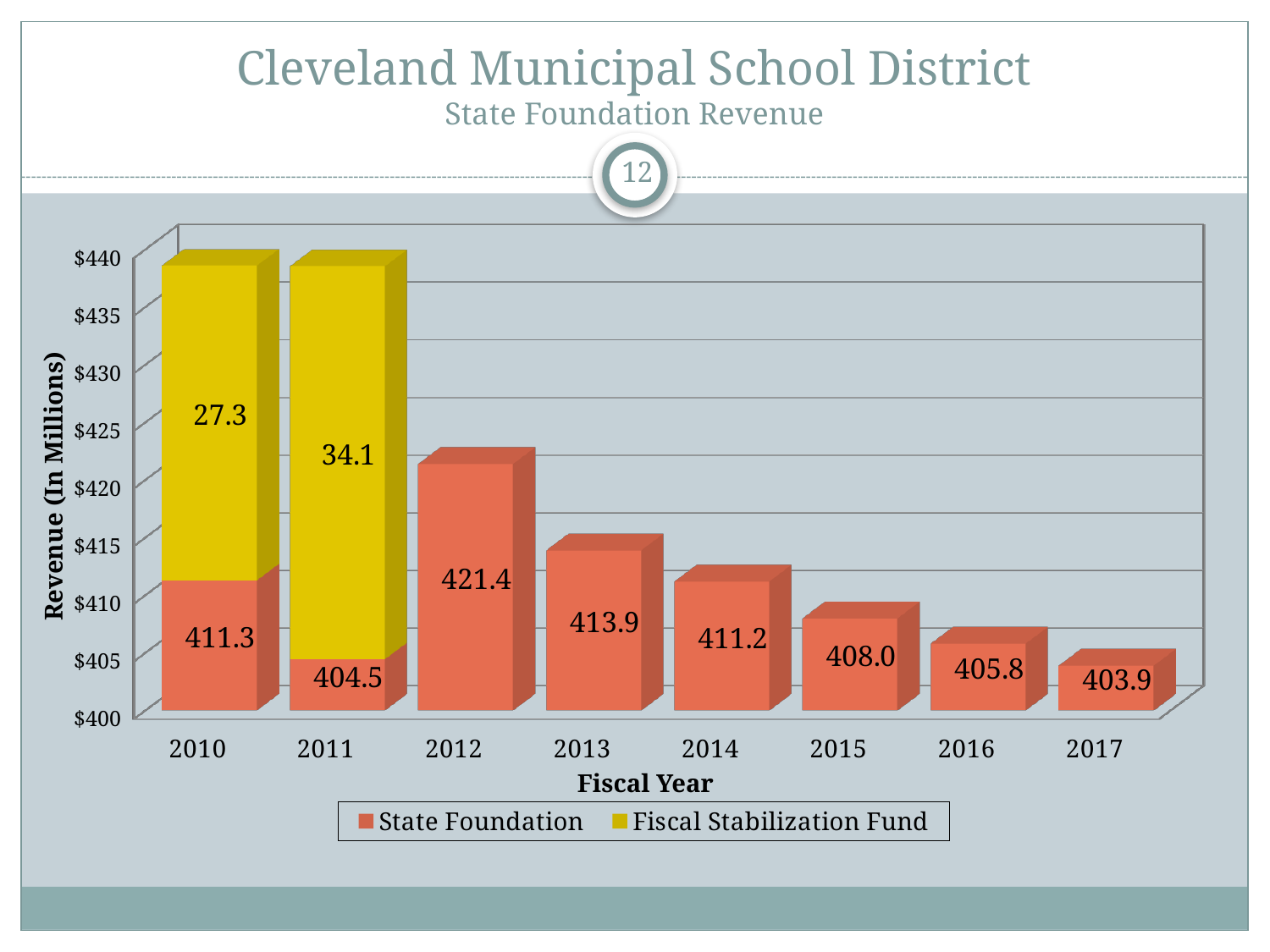
Which fiscal year has the highest State Foundation value? 2012 What is the Fiscal Stabilization Fund value for fiscal year 2011? 34.1 What is the State Foundation value for fiscal year 2012? 421.4 How many series does the legend list? 2 What is the total of the stacked bar for fiscal year 2011? 438.6 What is the difference between the State Foundation values for 2012 and 2013? 7.5 What is the State Foundation value for fiscal year 2010? 411.3 Which fiscal year has the lowest State Foundation value? 2017 What kind of chart is shown on the slide? Stacked bar chart Which is larger, the Fiscal Stabilization Fund value for 2010 or for 2011? 2011 How many fiscal years are shown on the x axis? 8 What is the label of the y axis? Revenue (In Millions)